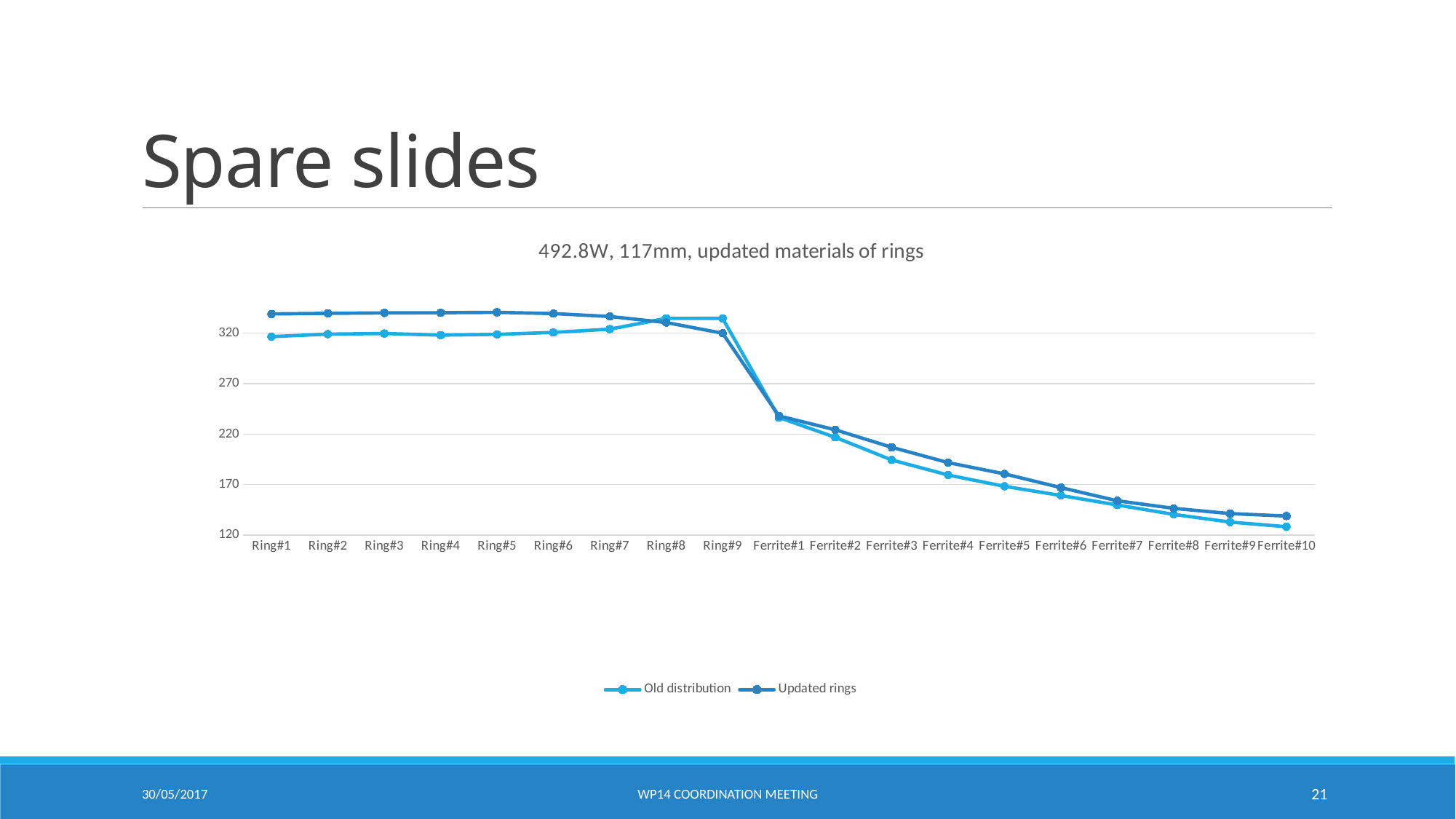
Is the value of Old distribution at Ferrite#10 greater or less than 170? less Do the values of the Updated rings series rise or fall from Ferrite#1 to Ferrite#10? fall At which category does the Old distribution series reach its lowest value? Ferrite#10 Is the value of Updated rings at Ring#1 greater or less than 320? greater How many categories are plotted along the x axis? 19 What is the title of the chart? 492.8W, 117mm, updated materials of rings How many series does the legend list? 2 Which series has the higher value at Ferrite#4? Updated rings What kind of chart is shown on the slide? line chart Is the value of Updated rings at Ferrite#3 greater or less than 220? less Which series has the higher value at Ring#9? Old distribution Which series has the higher value at Ring#1? Updated rings